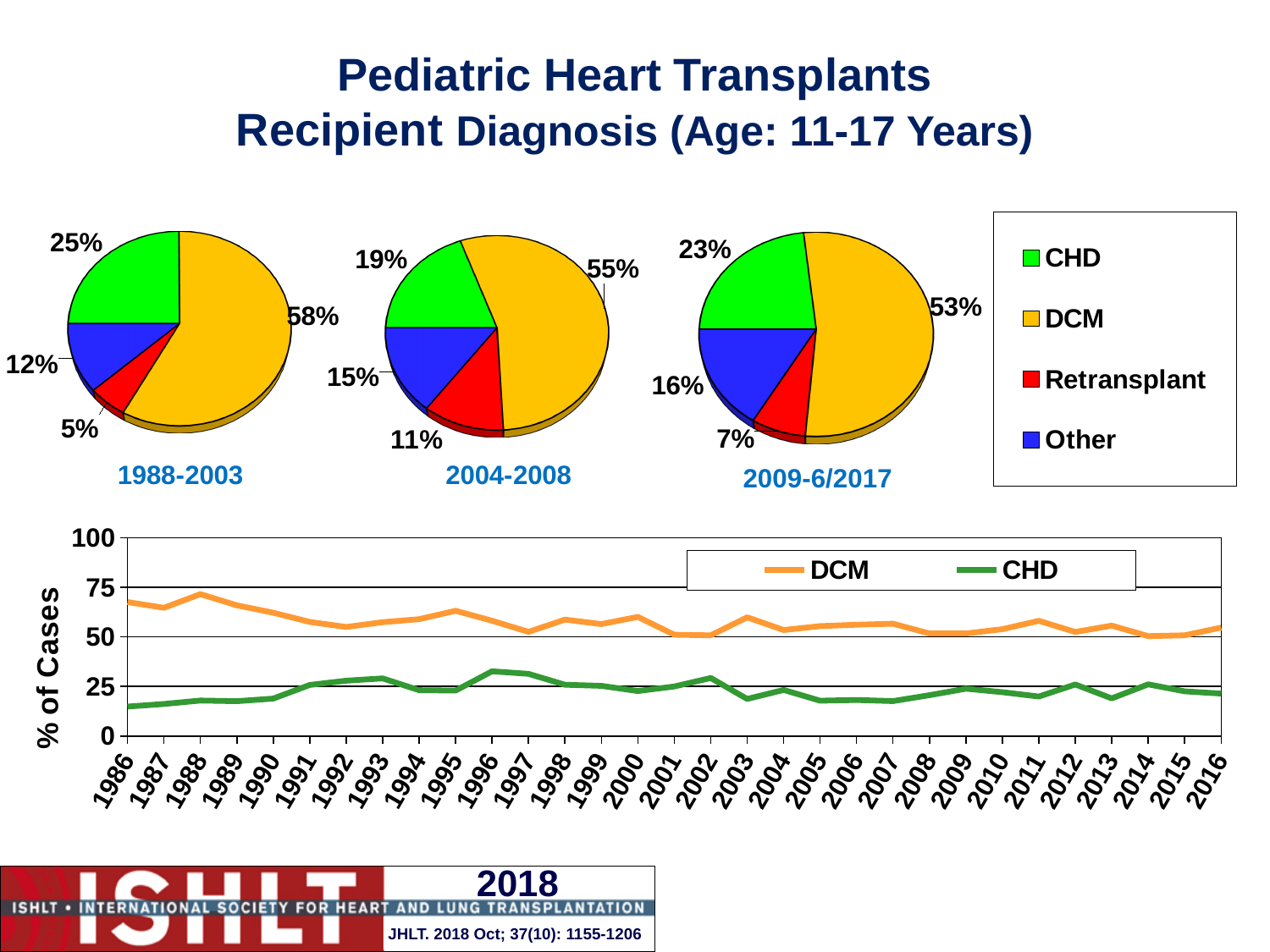
How many years are shown on the x axis of the line chart at the bottom? 31 In the line chart at the bottom, is the DCM value for 1988 greater or less than 50? greater In the line chart at the bottom, is the CHD value for 1986 greater or less than 25? less What type of chart is the chart at the bottom of the slide? Line chart In the 2004-2008 pie chart, what share of cases is Retransplant? 11% In the 1988-2003 pie chart, what share of cases is DCM? 58% In the 1988-2003 pie chart, which diagnosis has the smallest share? Retransplant Comparing the 1988-2003 and 2009-6/2017 pie charts, which period has the larger Retransplant share? 2009-6/2017 In the 2004-2008 pie chart, what is the difference between the CHD share and the Other share? 4% In the 2009-6/2017 pie chart, which diagnosis has the largest share? DCM In the 2009-6/2017 pie chart, what share of cases is Other? 16% How many series does the legend of the line chart at the bottom list? 2